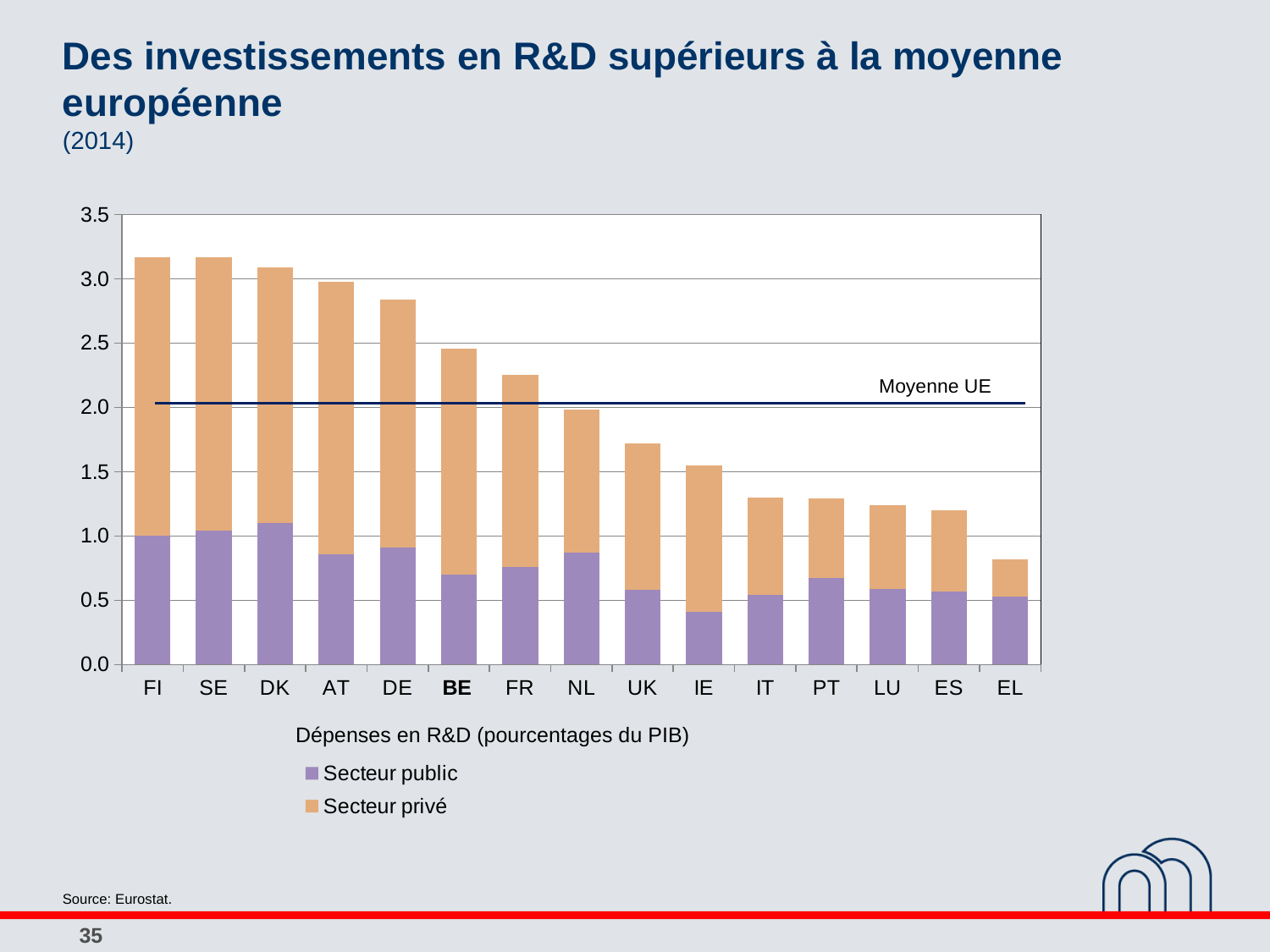
Is the total value for UK greater or less than 2.0? less What label is given to the horizontal line drawn across the chart? Moyenne UE Is the total value for BE greater or less than 2.0? greater Is the total value for EL greater or less than 1.0? less Which country has the lowest total R&D spending in the chart? EL Which has the larger total bar, BE or FR? BE How many countries are shown on the x axis of the chart? 15 What kind of chart is shown on the slide? Stacked bar chart How many series does the chart legend list? 2 Do the total bar heights rise or fall from left to right along the x axis? Fall